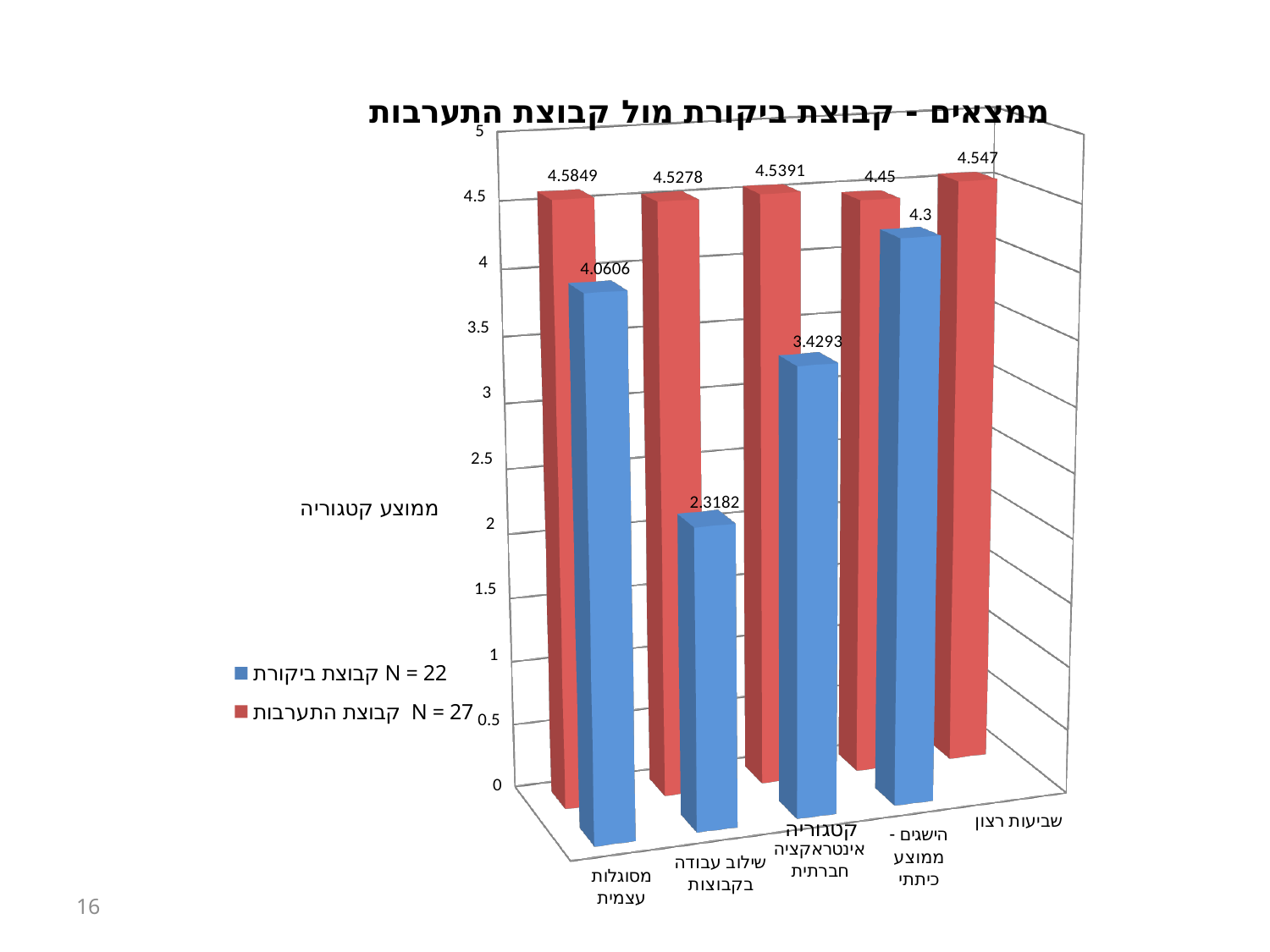
What is the difference between the intervention group and the control group values in the category שילוב עבודה בקבוצות? 2.2096 What kind of chart is shown on the slide? Bar chart According to the legend, what is the N for the control group (קבוצת ביקורת)? N = 22 What is the value for the intervention group (קבוצת התערבות) in the category מסוגלות עצמית? 4.5849 How many series does the legend list? 2 In the category הישגים - ממוצע כיתתי, which group has the larger value? קבוצת התערבות What is the value for the control group (קבוצת ביקורת) in the category שילוב עבודה בקבוצות? 2.3182 In which category does the intervention group (קבוצת התערבות) have its lowest value? הישגים - ממוצע כיתתי What is the value for the intervention group (קבוצת התערבות) in the category שביעות רצון? 4.547 In which category does the control group (קבוצת ביקורת) have its lowest value? שילוב עבודה בקבוצות What is the value for the control group (קבוצת ביקורת) in the category אינטראקציה חברתית? 3.4293 How many categories are shown on the x axis of the chart? 5